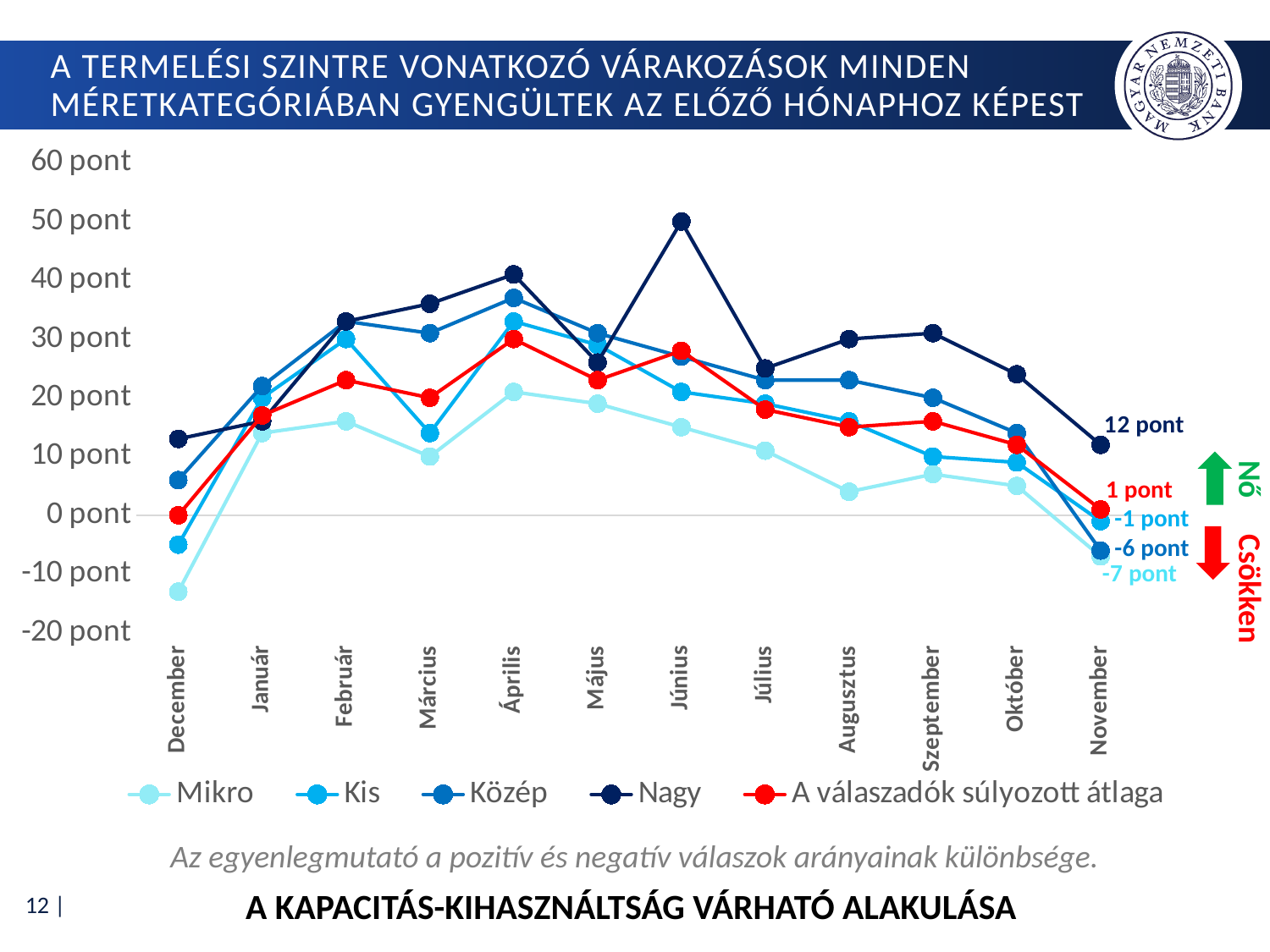
What is the value of the Mikro series in November? -7 pont What kind of chart is shown on the slide? line chart Is the value for Nagy in Június greater or less than 40 pont? greater How many months are plotted along the x axis? 12 In November, which is larger: the Kis value or the Közép value? Kis What is the value of 'A válaszadók súlyozott átlaga' in November? 1 pont Which series has the highest value in November? Nagy Which series has the lowest value in November? Mikro Which series is drawn with the red line? A válaszadók súlyozott átlaga What is the difference between the Nagy and Mikro values in November? 19 pont How many series does the legend list? 5 What is the value of the Nagy series in November? 12 pont